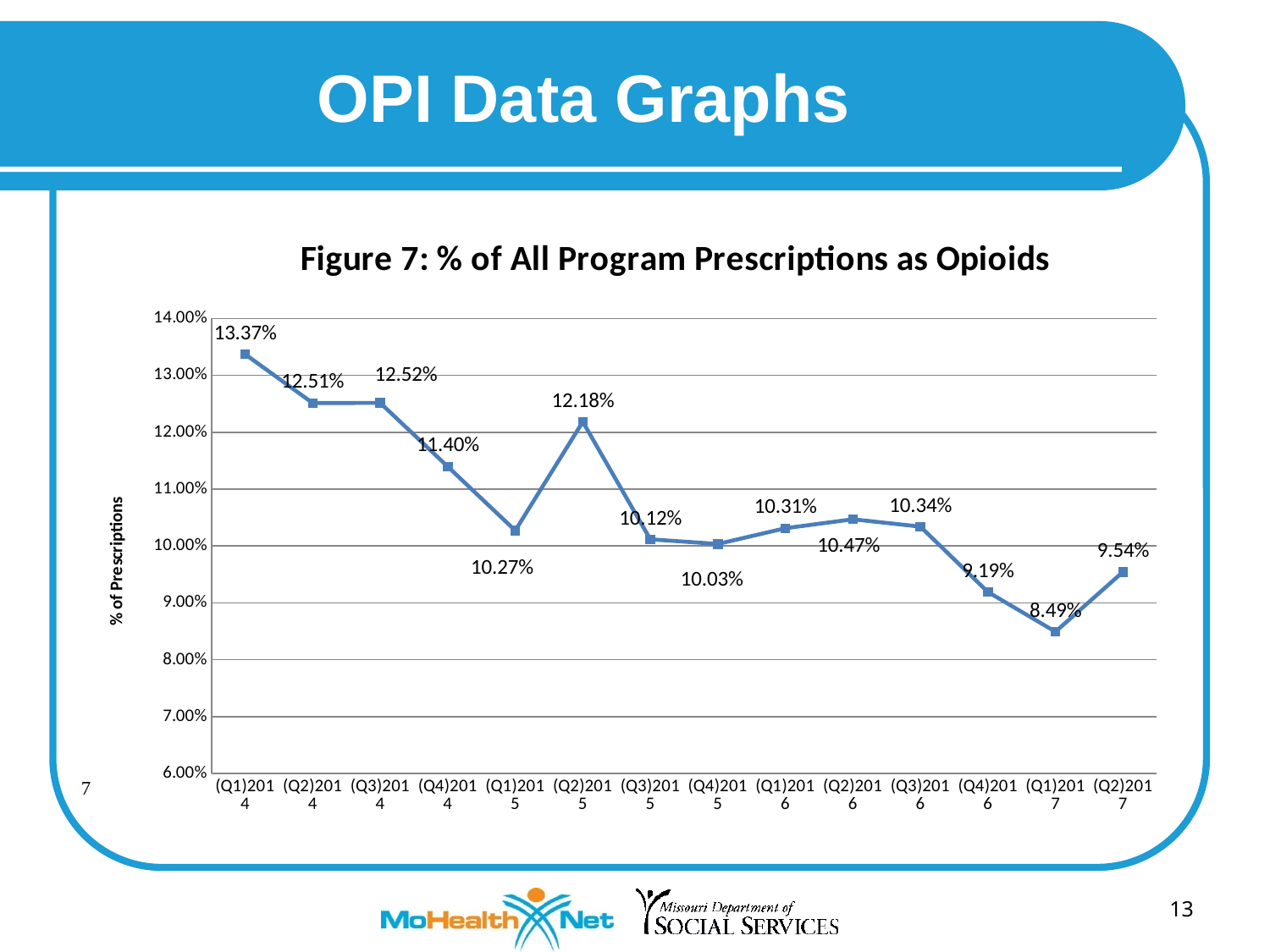
What is the value for (Q1)2014? 13.37% Is the value for (Q4)2014 greater or less than 11.00%? greater How many quarters are plotted on the chart? 14 What kind of chart is shown on the slide? line chart What is the value for (Q1)2017? 8.49% What is the difference between the values for (Q1)2014 and (Q1)2017? 4.88% Which is larger, the value for (Q2)2015 or the value for (Q3)2015? (Q2)2015 Overall, do the values rise or fall from (Q1)2014 to (Q2)2017? fall Which quarter has the highest percentage of prescriptions as opioids? (Q1)2014 What is the value for (Q2)2017? 9.54% What is the value for (Q2)2015? 12.18% Which quarter has the lowest percentage of prescriptions as opioids? (Q1)2017